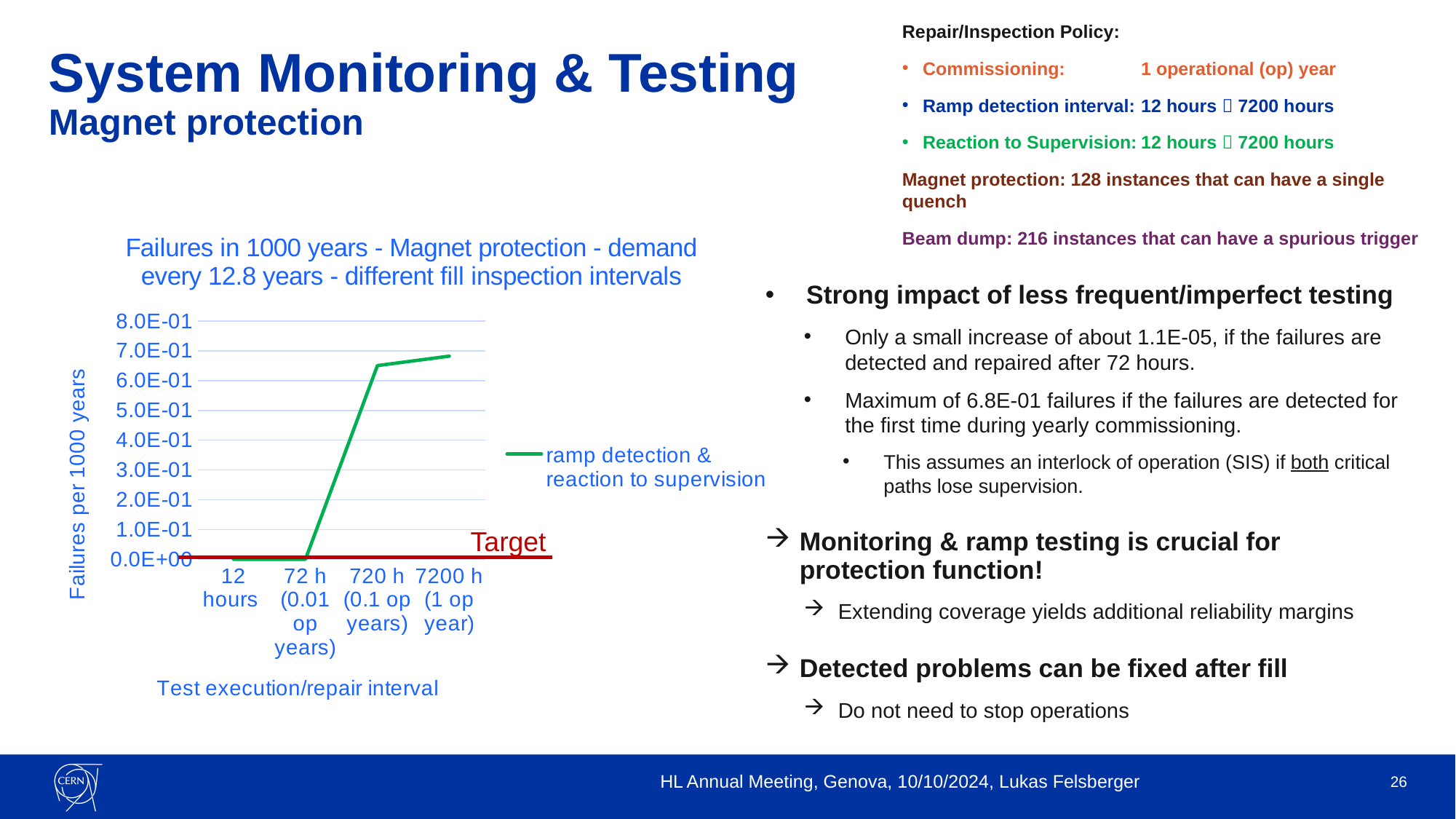
Do the failures per 1000 years rise or fall as the test execution/repair interval increases along the x axis? rise How many test execution/repair intervals are plotted along the x axis? 4 Which test execution/repair interval has the highest failures per 1000 years? 7200 h (1 op year) What is the label of the y axis? Failures per 1000 years Is the value for 12 hours greater or less than 1.0E-01? less Which has the larger failures per 1000 years: 72 h (0.01 op years) or 720 h (0.1 op years)? 720 h (0.1 op years) What kind of chart is shown on the slide? line chart Is the value for 7200 h (1 op year) greater or less than 6.0E-01? greater How many series does the chart legend list? 1 Is the value for 72 h (0.01 op years) greater or less than 1.0E-01? less What is the legend entry for the green line? ramp detection & reaction to supervision